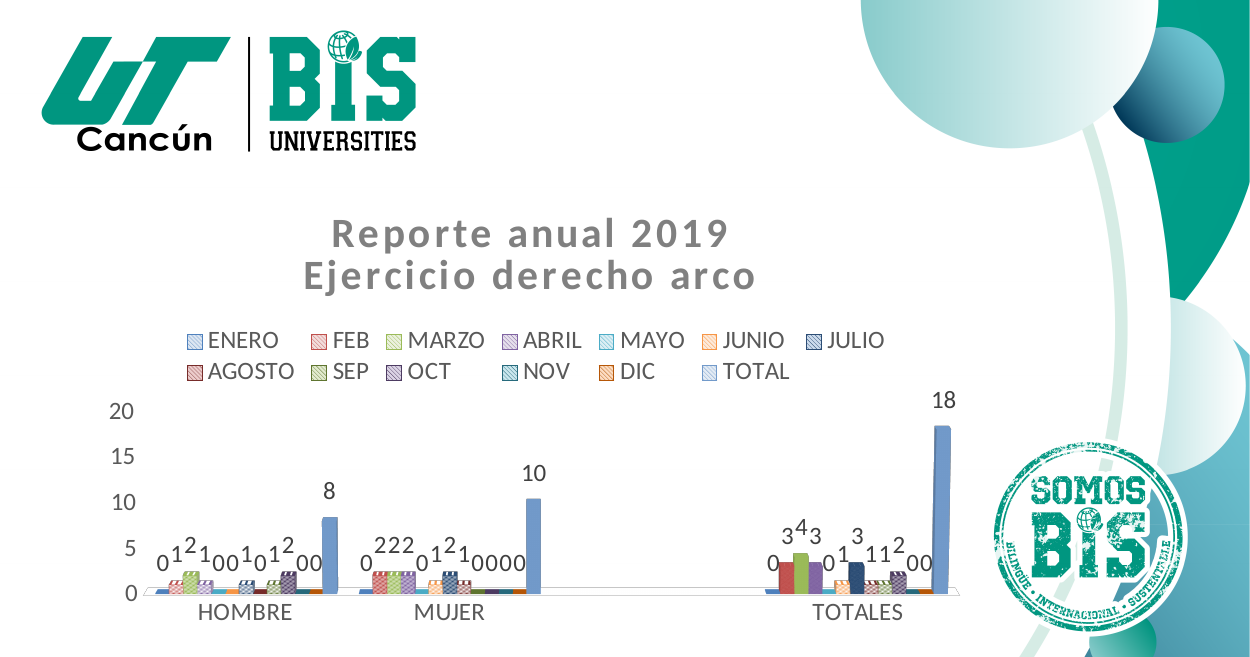
How many series does the legend list? 13 How many categories are shown on the x axis? 3 Which category has the highest TOTAL value? TOTALES What is the TOTAL value for MUJER? 10 What kind of chart is shown on the slide? bar chart What is the TOTAL value for TOTALES? 18 What is the TOTAL value for HOMBRE? 8 What is the title of the chart? Reporte anual 2019 Ejercicio derecho arco Is the TOTAL value for TOTALES greater or less than 15? greater What is the difference between the TOTAL values for MUJER and HOMBRE? 2 Which category has the lowest TOTAL value? HOMBRE Which is larger, the TOTAL value for MUJER or for HOMBRE? MUJER